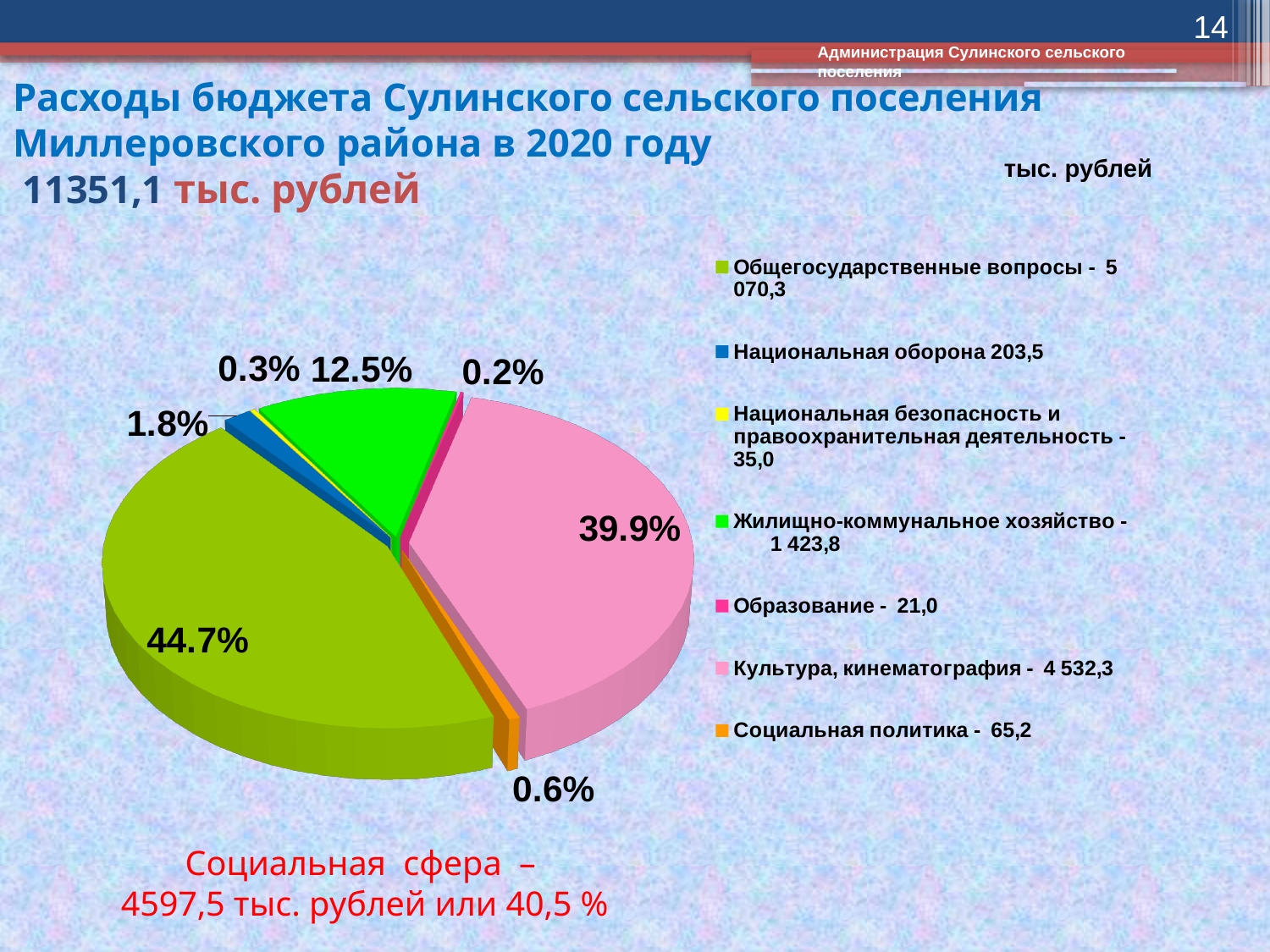
Which is larger: Культура, кинематография or Жилищно-коммунальное хозяйство? Культура, кинематография What kind of chart is shown on the slide? Pie chart How many categories does the pie chart have? 7 What share of the pie does Жилищно-коммунальное хозяйство take? 12.5% Which category has the smallest slice of the pie? Образование What is the value for Социальная политика according to the legend? 65,2 What is the value for Национальная оборона according to the legend? 203,5 Which category has the largest slice of the pie? Общегосударственные вопросы What is the difference between the values for Общегосударственные вопросы (5 070,3) and Культура, кинематография (4 532,3)? 538,0 What share of the pie does Общегосударственные вопросы take? 44.7% What colour is the slice for Культура, кинематография? Pink What share of the pie does Культура, кинематография take? 39.9%